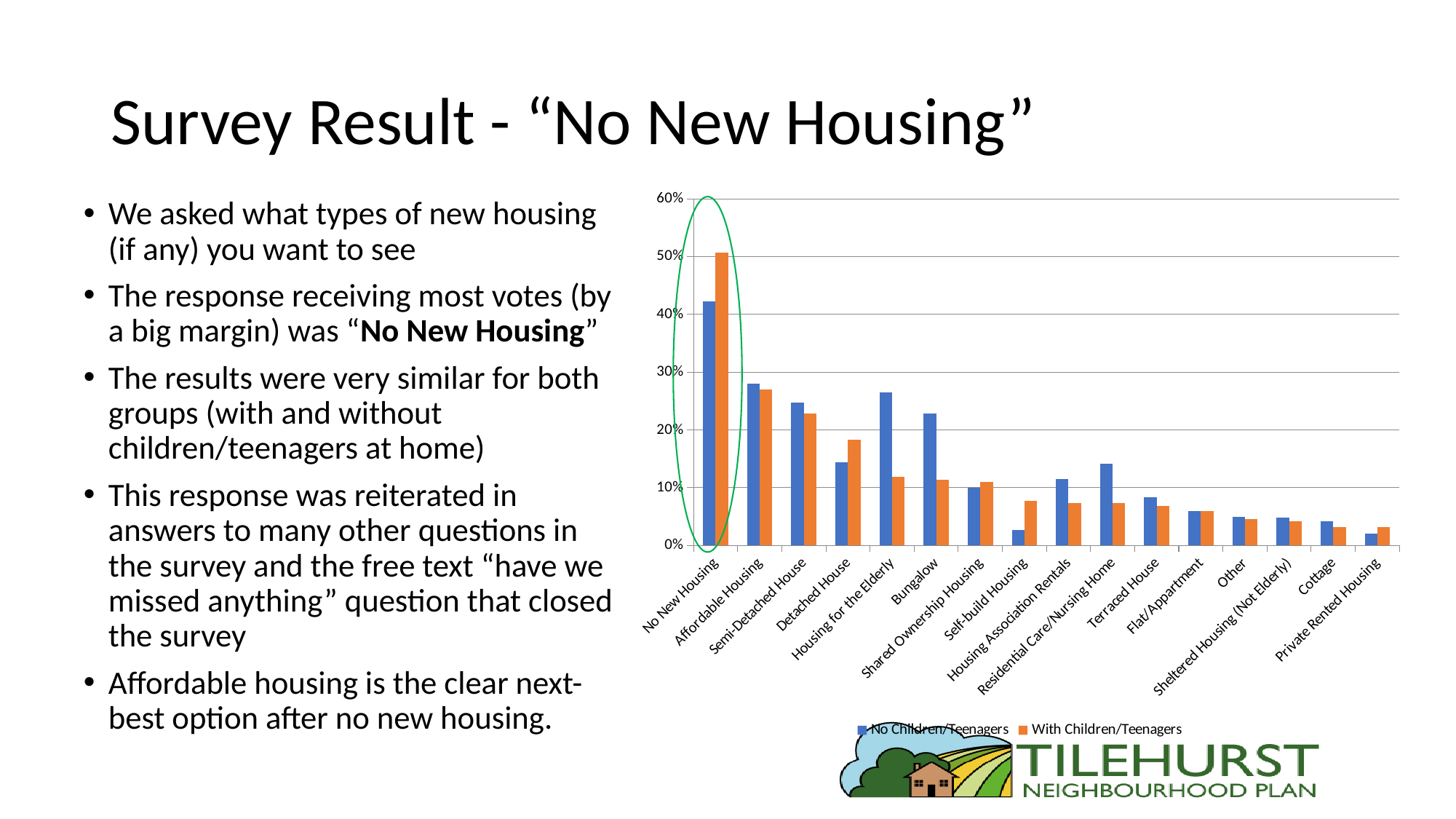
How many housing categories are shown on the x axis of the chart? 16 What kind of chart is shown on the slide? Bar chart Is the No Children/Teenagers value for Affordable Housing greater or less than 30%? less For Detached House, which series has the larger value: No Children/Teenagers or With Children/Teenagers? With Children/Teenagers How many series does the chart legend list? 2 Which housing category has the highest value for the With Children/Teenagers series? No New Housing Is the With Children/Teenagers value for Detached House greater or less than 20%? less For Housing for the Elderly, which series has the larger value: No Children/Teenagers or With Children/Teenagers? No Children/Teenagers Which colour represents the With Children/Teenagers series in the chart? Orange Is the No Children/Teenagers value for Self-build Housing greater or less than 10%? less Which housing category has the highest value for the No Children/Teenagers series? No New Housing